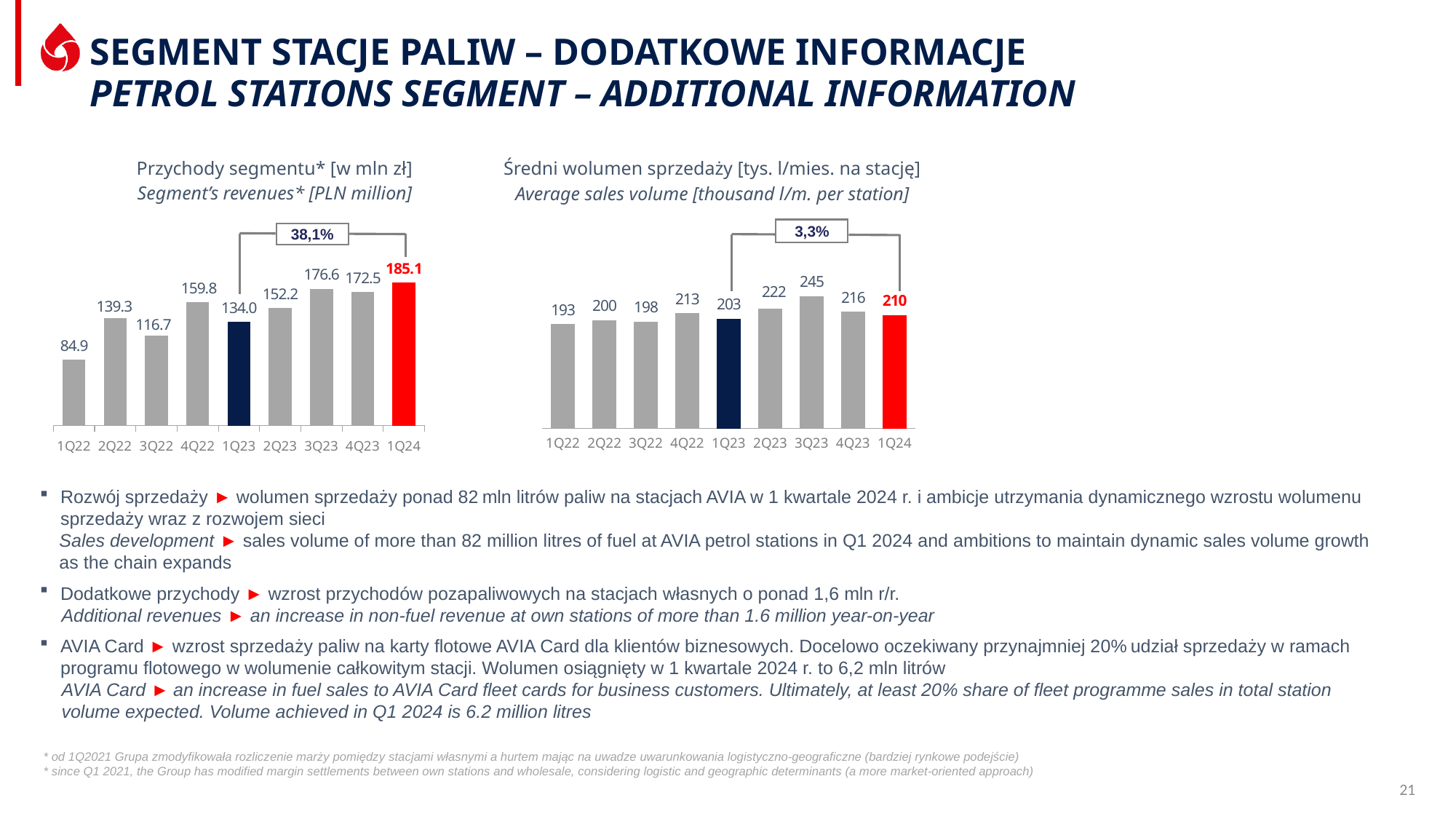
In the Segment's revenues chart, what is the value for 1Q24? 185.1 In the Segment's revenues chart, how many quarters are shown? 9 In the Average sales volume chart, what is the value for 3Q23? 245 In the Average sales volume chart, which quarter has the highest value? 3Q23 In the Average sales volume chart, what is the difference between 3Q23 and 4Q23? 29 In the Segment's revenues chart, what is the value for 3Q22? 116.7 In the Segment's revenues chart, which quarter has the highest value? 1Q24 What type of chart is the Segment's revenues chart? Bar chart In the Average sales volume chart, what is the value for 1Q22? 193 In the Average sales volume chart, which is larger, 4Q22 or 2Q23? 2Q23 In the Segment's revenues chart, what is the difference between 1Q24 and 1Q23? 51.1 In the Segment's revenues chart, which quarter has the lowest value? 1Q22